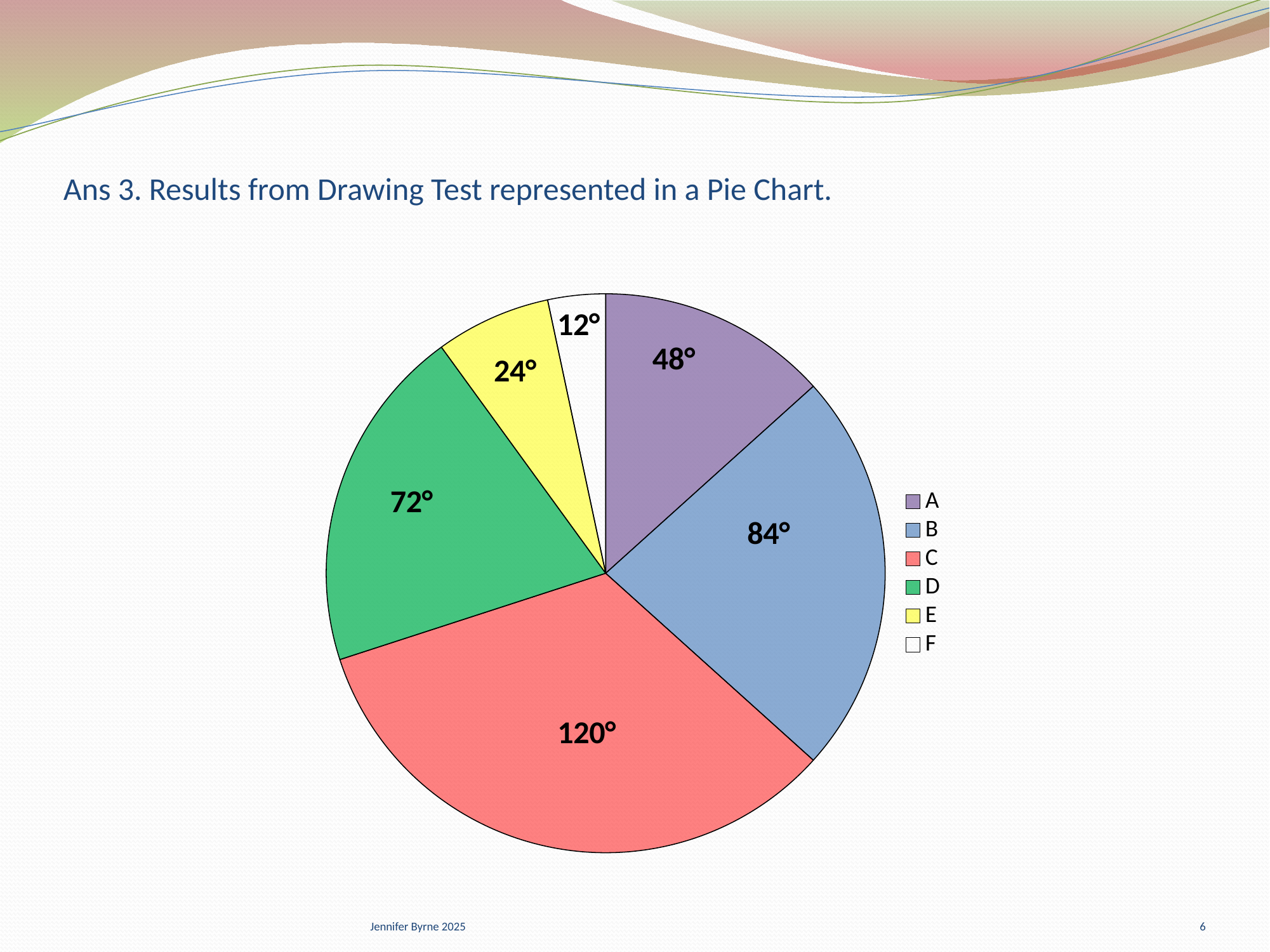
What is the total of all the slice values? 360° What is the difference between the values for B and D? 12° What share of the pie does slice C represent? One third What is the value shown for slice A? 48° What kind of chart is shown on the slide? Pie chart What is the value shown for slice E? 24° How many slices does the pie chart have? 6 Which is larger, the value for D or the value for A? D What colour is the slice for category D? Green What is the value shown for slice C? 120° Which category has the smallest slice? F Which category has the largest slice? C